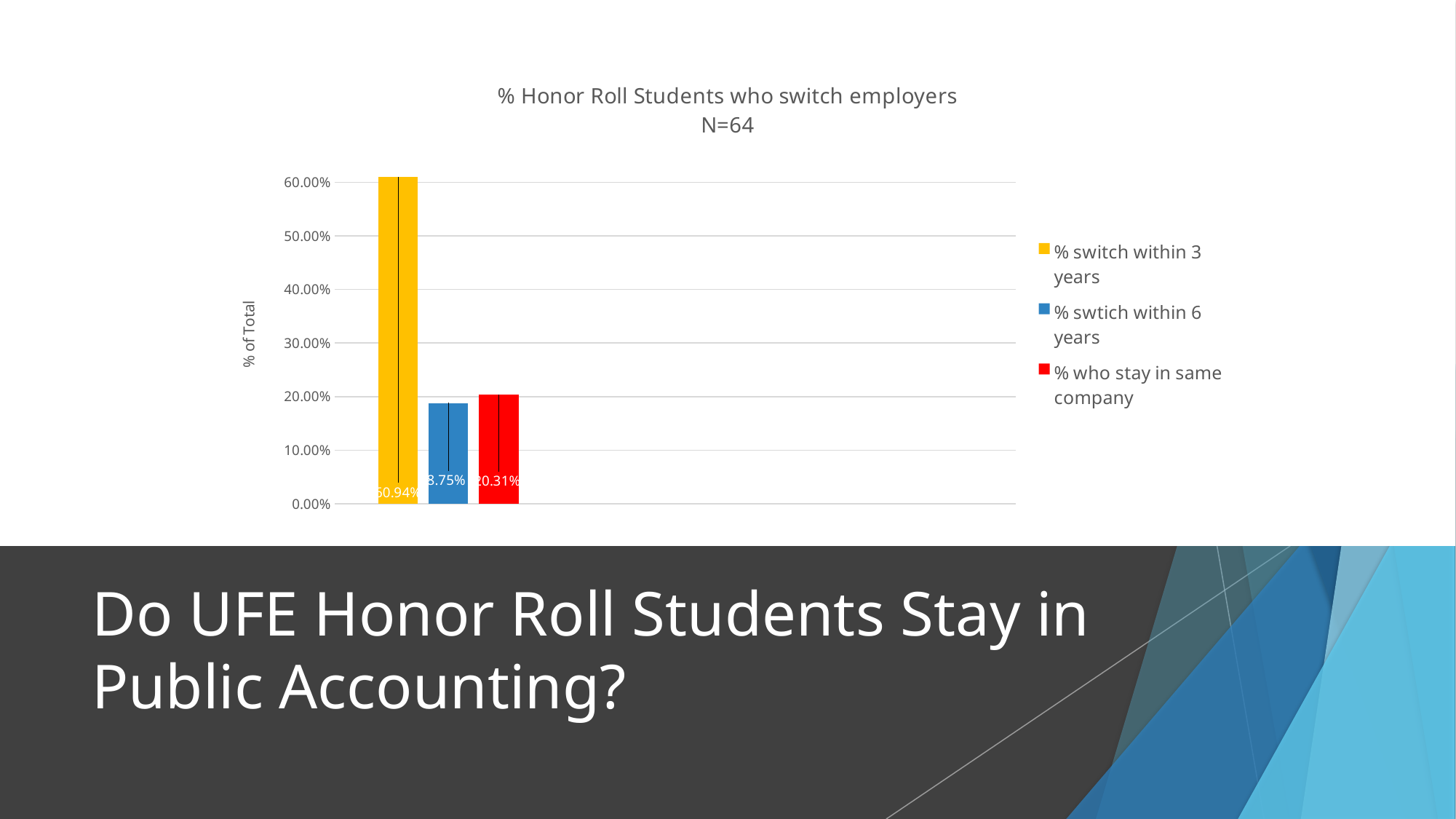
Which series has the highest value? % switch within 3 years What is the value for "% switch within 3 years"? 60.94% Is the value for "% swtich within 6 years" greater or less than 20.00%? less What is the label on the vertical axis of the chart? % of Total How many bars are plotted in the chart? 3 Which series has the lowest value? % swtich within 6 years Is the value for "% switch within 3 years" greater or less than 50.00%? greater What kind of chart is shown on the slide? bar chart What is the value for "% who stay in same company"? 20.31% Which is larger: "% switch within 3 years" or "% who stay in same company"? % switch within 3 years How many series does the legend list? 3 What is the difference between "% switch within 3 years" and "% who stay in same company"? 40.63%